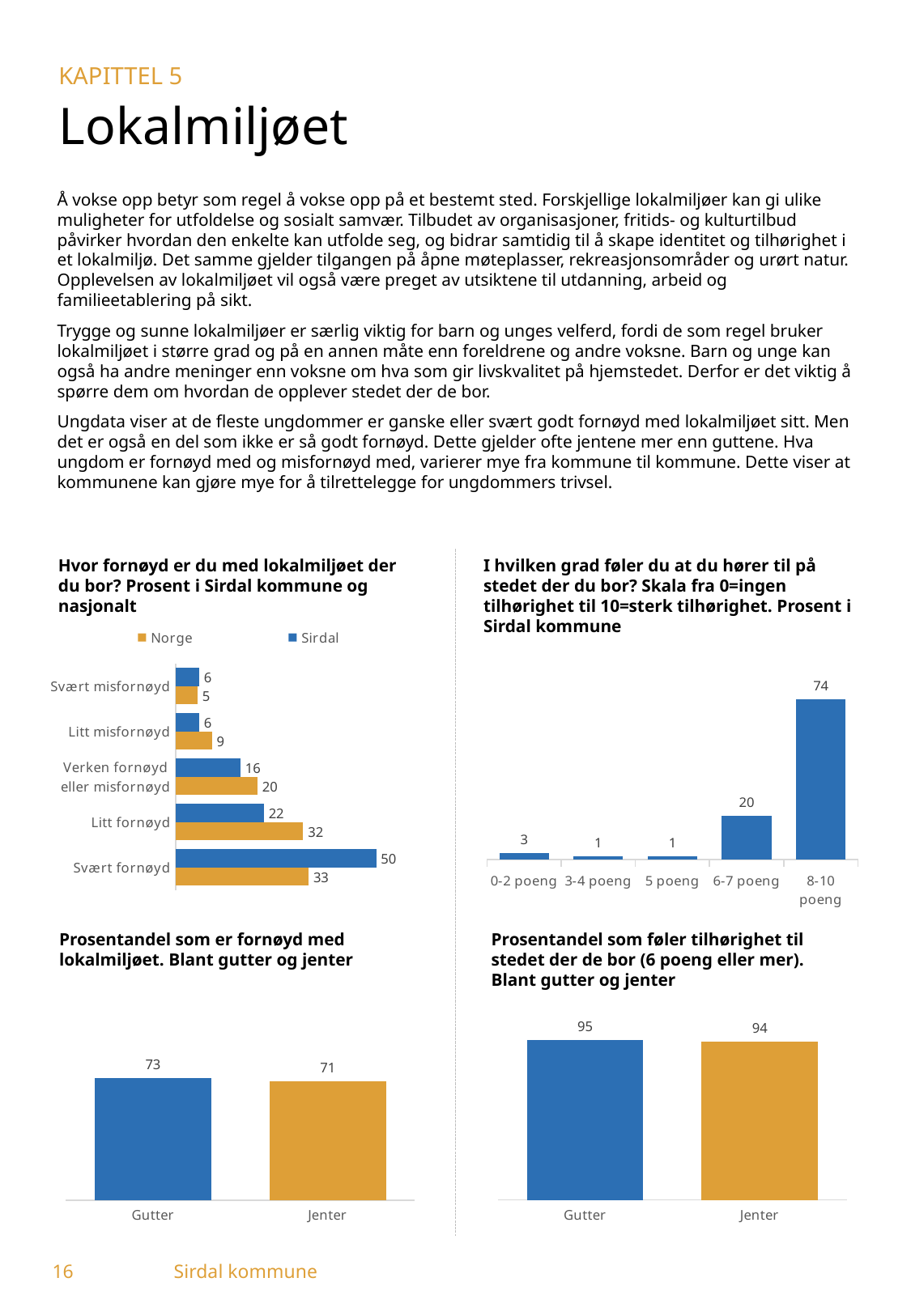
In the top-right chart 'I hvilken grad føler du at du hører til på stedet der du bor?', what is the value for '6-7 poeng'? 20 In the bottom-right chart 'Prosentandel som føler tilhørighet til stedet der de bor', what is the value for Gutter? 95 In the top-left chart 'Hvor fornøyd er du med lokalmiljøet der du bor?', what is the Norge value for 'Litt fornøyd'? 32 In the bottom-left chart 'Prosentandel som er fornøyd med lokalmiljøet', what is the value for Jenter? 71 In the top-left chart 'Hvor fornøyd er du med lokalmiljøet der du bor?', what is the Sirdal value for 'Svært fornøyd'? 50 In the top-left chart 'Hvor fornøyd er du med lokalmiljøet der du bor?', which is larger for 'Litt misfornøyd': Norge or Sirdal? Norge In the bottom-left chart 'Prosentandel som er fornøyd med lokalmiljøet', what is the difference between Gutter and Jenter? 2 What kind of chart is the top-left chart 'Hvor fornøyd er du med lokalmiljøet der du bor?'? Bar chart In the top-right chart 'I hvilken grad føler du at du hører til på stedet der du bor?', how many categories are shown on the x axis? 5 In the top-right chart 'I hvilken grad føler du at du hører til på stedet der du bor?', which category has the highest value? 8-10 poeng In the top-left chart 'Hvor fornøyd er du med lokalmiljøet der du bor?', what is the difference between the Sirdal and Norge values for 'Svært fornøyd'? 17 In the top-left chart 'Hvor fornøyd er du med lokalmiljøet der du bor?', how many series does the legend list? 2